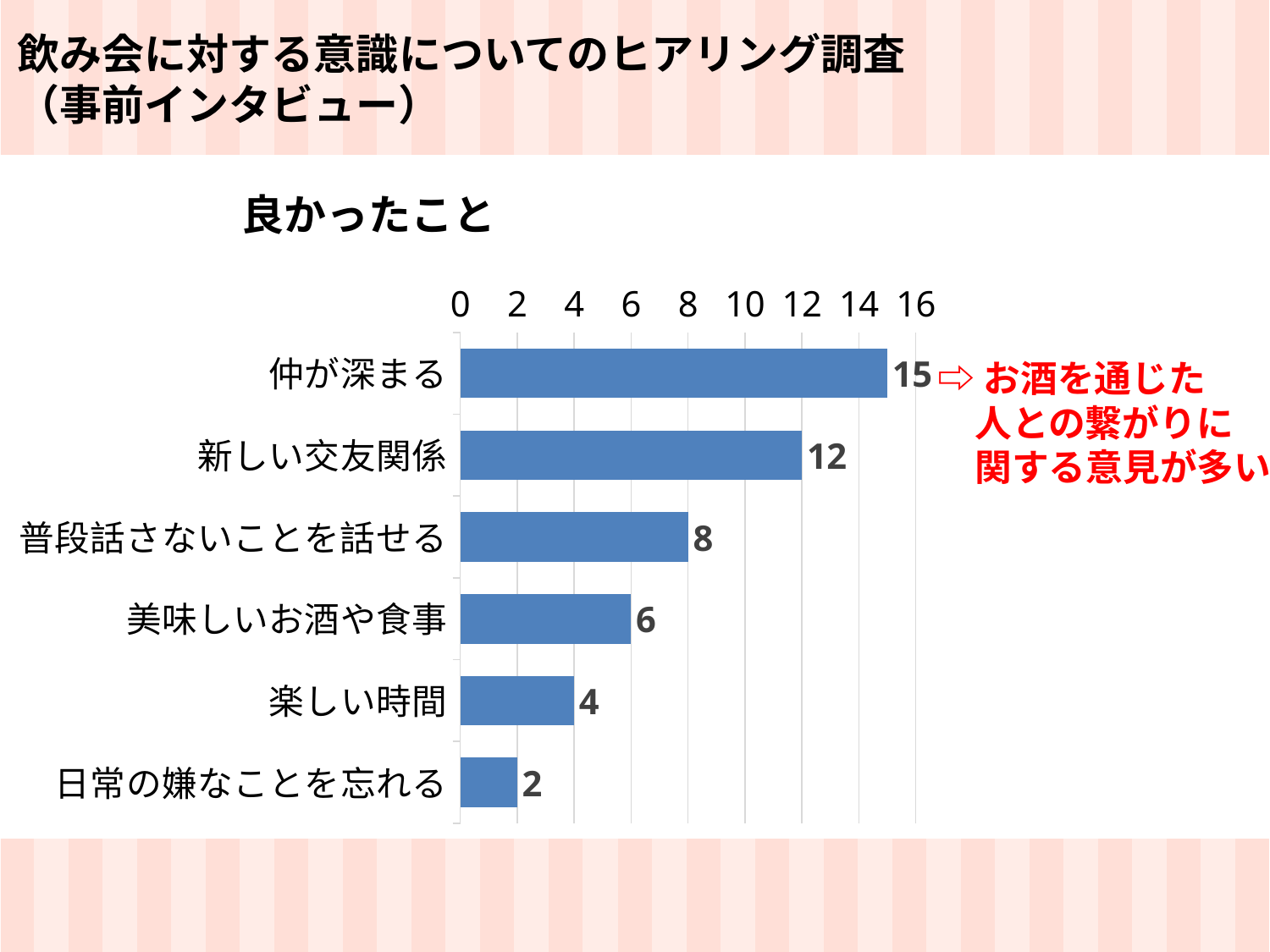
What is the value for 新しい交友関係? 12 What is the title of the chart? 良かったこと What is the difference between the values for 美味しいお酒や食事 and 楽しい時間? 2 What is the difference between the values for 仲が深まる and 新しい交友関係? 3 How many categories are shown in the chart? 6 Which category has the highest value? 仲が深まる What is the value for 日常の嫌なことを忘れる? 2 What is the value for 仲が深まる? 15 Which is larger, the value for 普段話さないことを話せる or the value for 美味しいお酒や食事? 普段話さないことを話せる Which category has the lowest value? 日常の嫌なことを忘れる What is the value for 普段話さないことを話せる? 8 What kind of chart is shown on the slide? bar chart